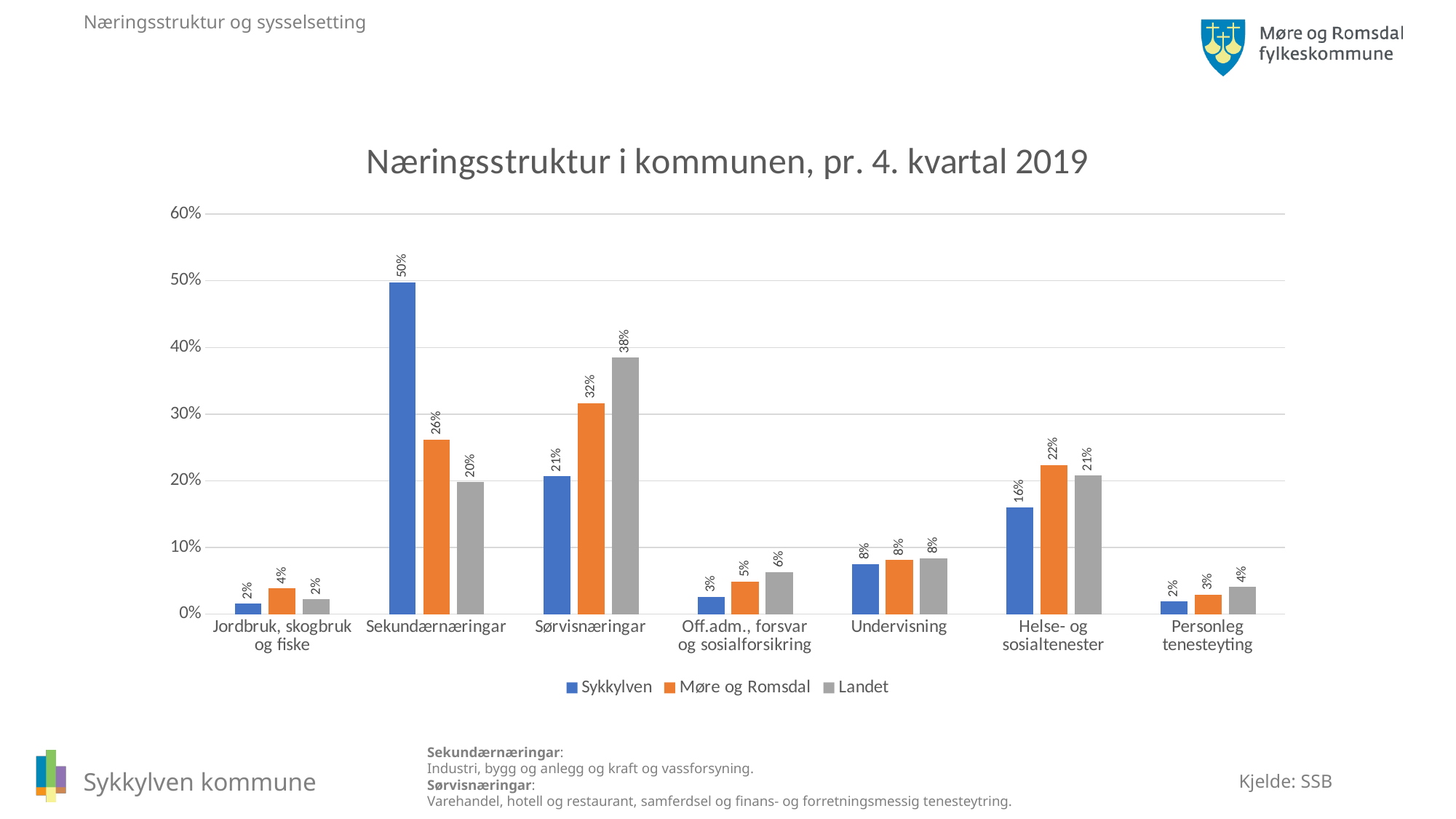
Is the value for Møre og Romsdal in Sekundærnæringar greater or less than 30%? less What kind of chart is shown? Bar chart What is the value for Sykkylven in Sekundærnæringar? 50% Which category has the highest value for Sykkylven? Sekundærnæringar What is the difference between Sykkylven and Landet in Sekundærnæringar? 30 percentage points How many categories are shown on the x axis? 7 Which is larger in Sørvisnæringar: Sykkylven or Møre og Romsdal? Møre og Romsdal What is the value for Møre og Romsdal in Helse- og sosialtenester? 22% How many series does the legend list? 3 What is the title of the chart? Næringsstruktur i kommunen, pr. 4. kvartal 2019 Which category has the lowest value for Møre og Romsdal? Personleg tenesteyting What is the value for Landet in Sørvisnæringar? 38%